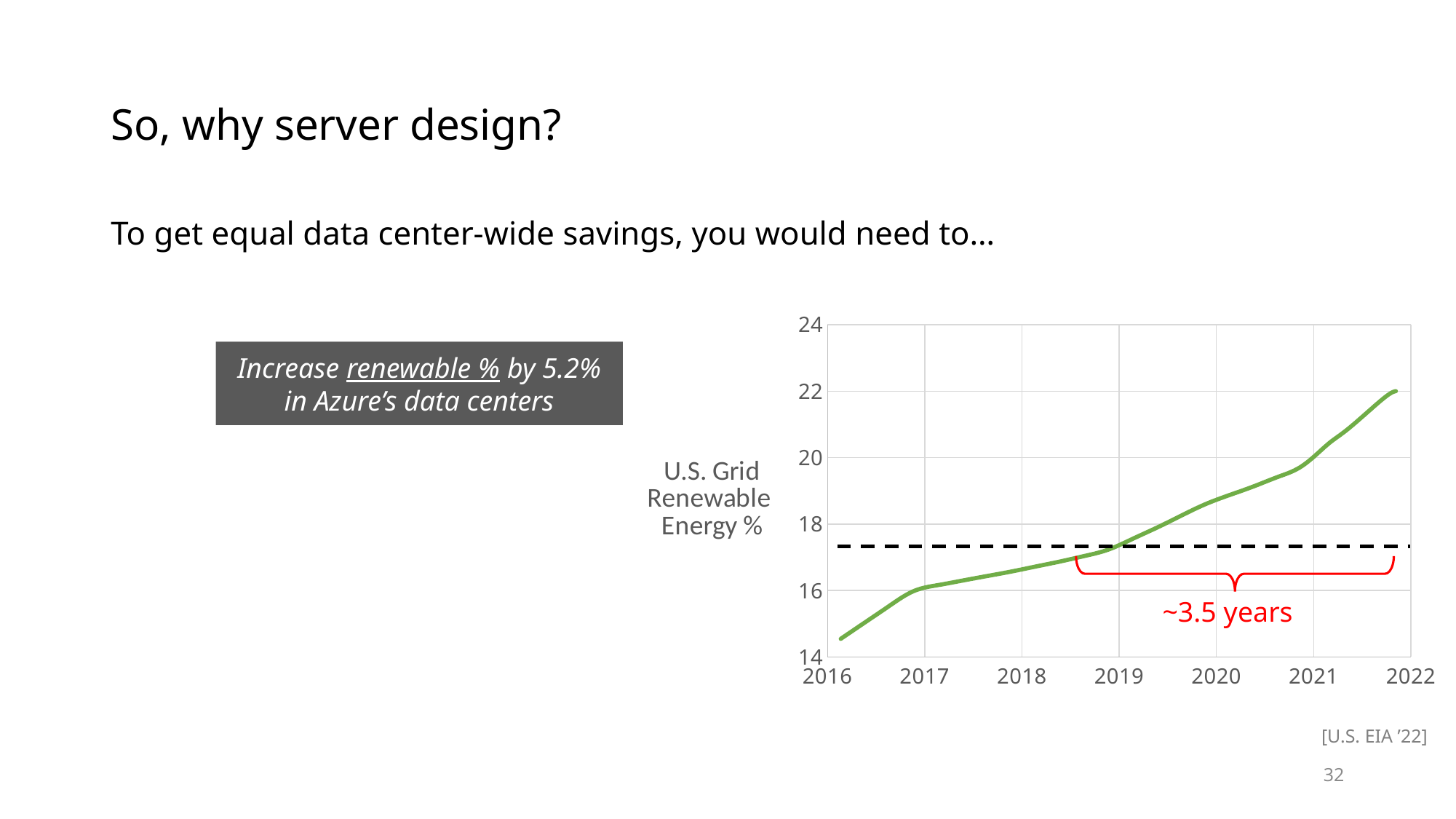
What label is given to the y axis of the chart? U.S. Grid Renewable Energy % Which year has the highest U.S. Grid Renewable Energy %? 2022 What kind of chart is shown on the slide? line chart Which year has a higher value, 2018 or 2021? 2021 How many year labels are shown on the x axis? 7 Is the value for 2022 greater or less than 20? greater Does the U.S. Grid Renewable Energy % rise or fall from 2016 to 2022? rise Which year has the lowest U.S. Grid Renewable Energy %? 2016 Is the value for 2016 greater or less than 16? less Is the value for 2018 greater or less than 18? less